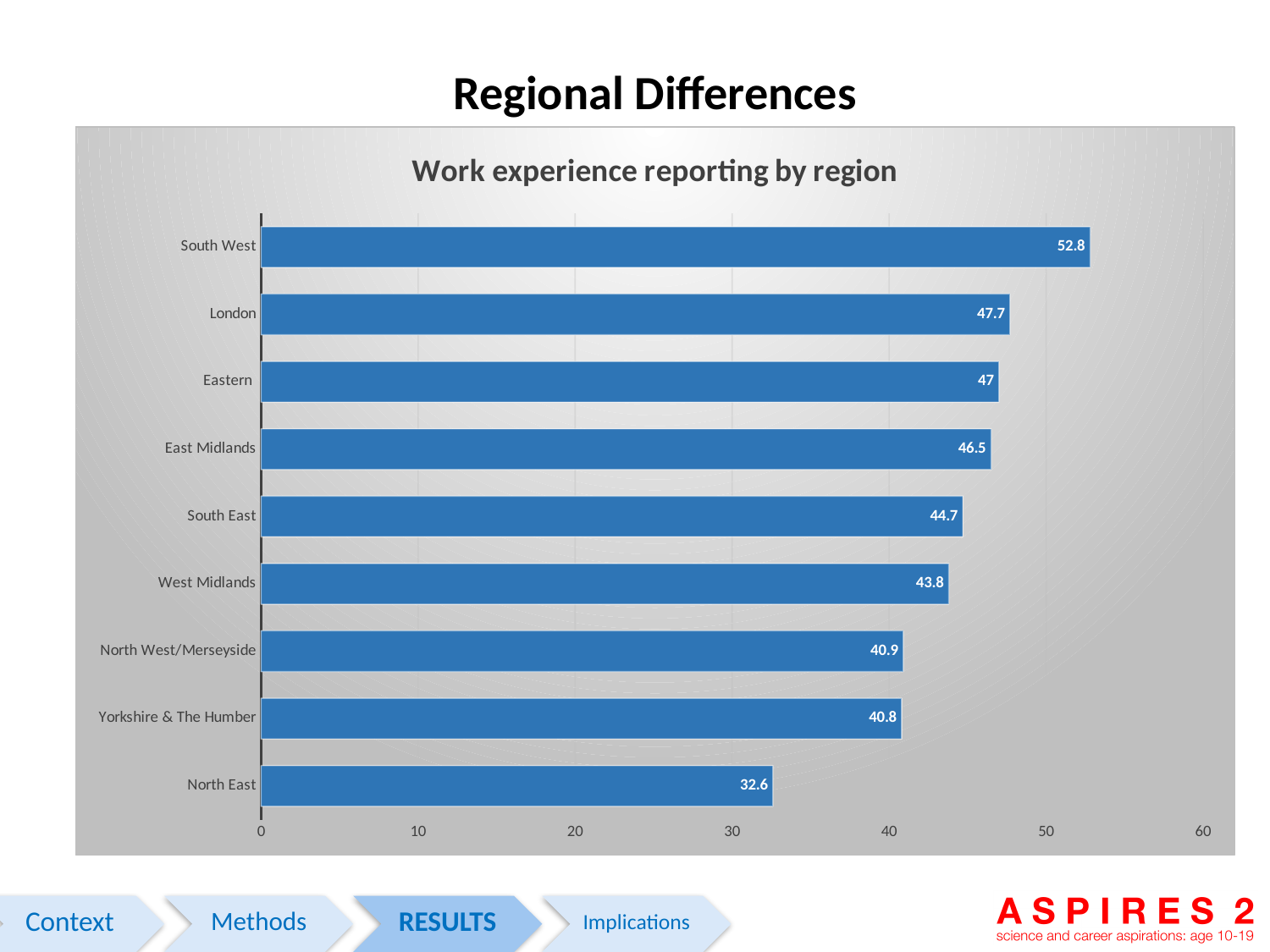
Which is larger, the value for South East or the value for West Midlands? South East What is the difference between the values for London and Eastern? 0.7 What kind of chart is this? Bar chart What is the difference between the values for South West and North East? 20.2 How many regions are shown in the chart? 9 What is the title of the chart? Work experience reporting by region What is the value for South West? 52.8 Is the value for North West/Merseyside greater or less than 40? greater Which region has the lowest value? North East Which region has the highest value? South West What is the value for East Midlands? 46.5 What is the value for North East? 32.6